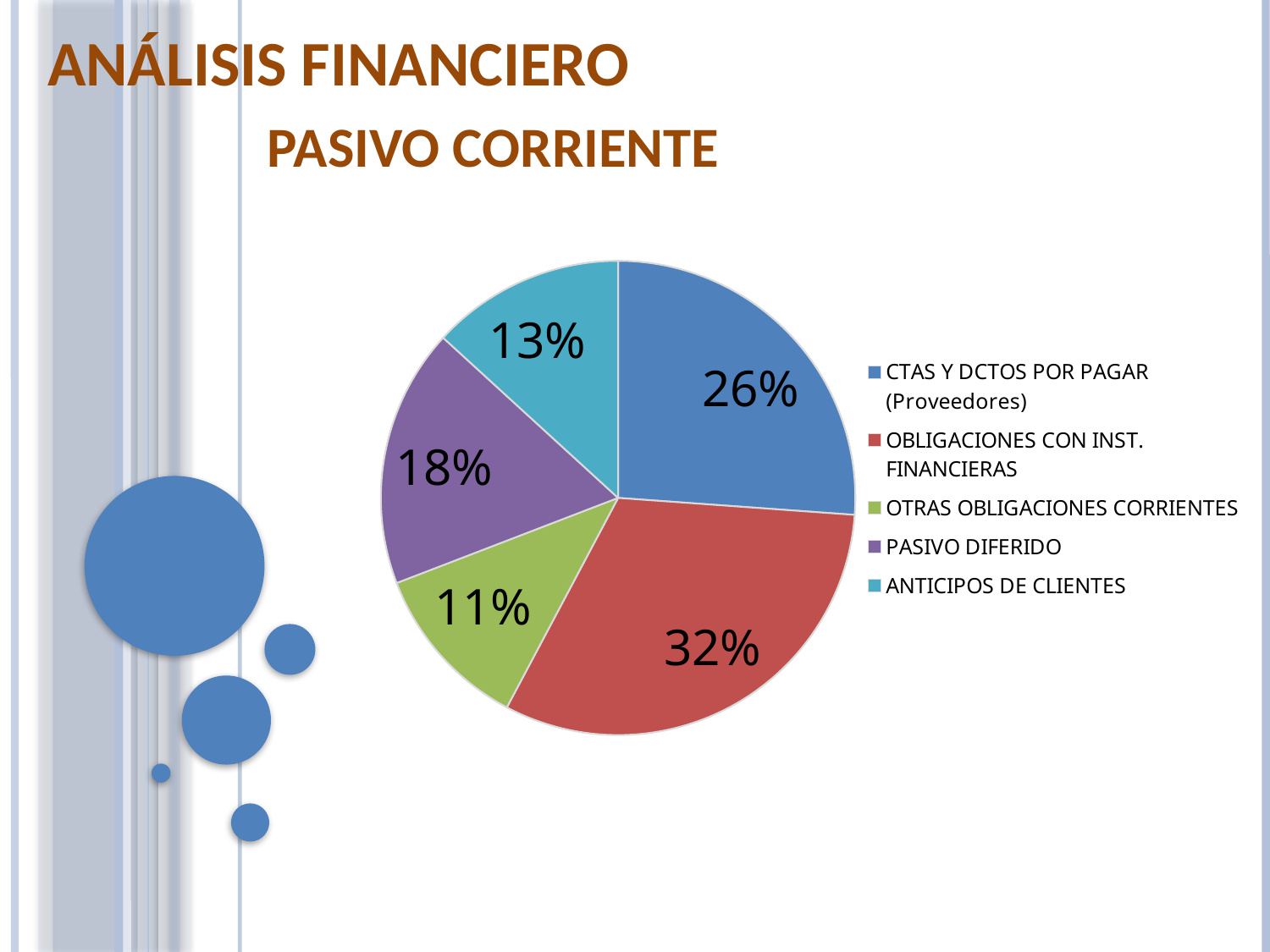
What share of the pie does PASIVO DIFERIDO represent? 18% Which category has the largest slice of the pie? OBLIGACIONES CON INST. FINANCIERAS What kind of chart is shown on the slide? Pie chart What is the difference in percentage points between OBLIGACIONES CON INST. FINANCIERAS and CTAS Y DCTOS POR PAGAR (Proveedores)? 6% How many categories are shown in the pie chart? 5 What share of the pie does ANTICIPOS DE CLIENTES represent? 13% Which is larger, PASIVO DIFERIDO or ANTICIPOS DE CLIENTES? PASIVO DIFERIDO What share of the pie does OBLIGACIONES CON INST. FINANCIERAS represent? 32% What colour is the slice for ANTICIPOS DE CLIENTES? Teal (light blue) Which category has the smallest slice of the pie? OTRAS OBLIGACIONES CORRIENTES